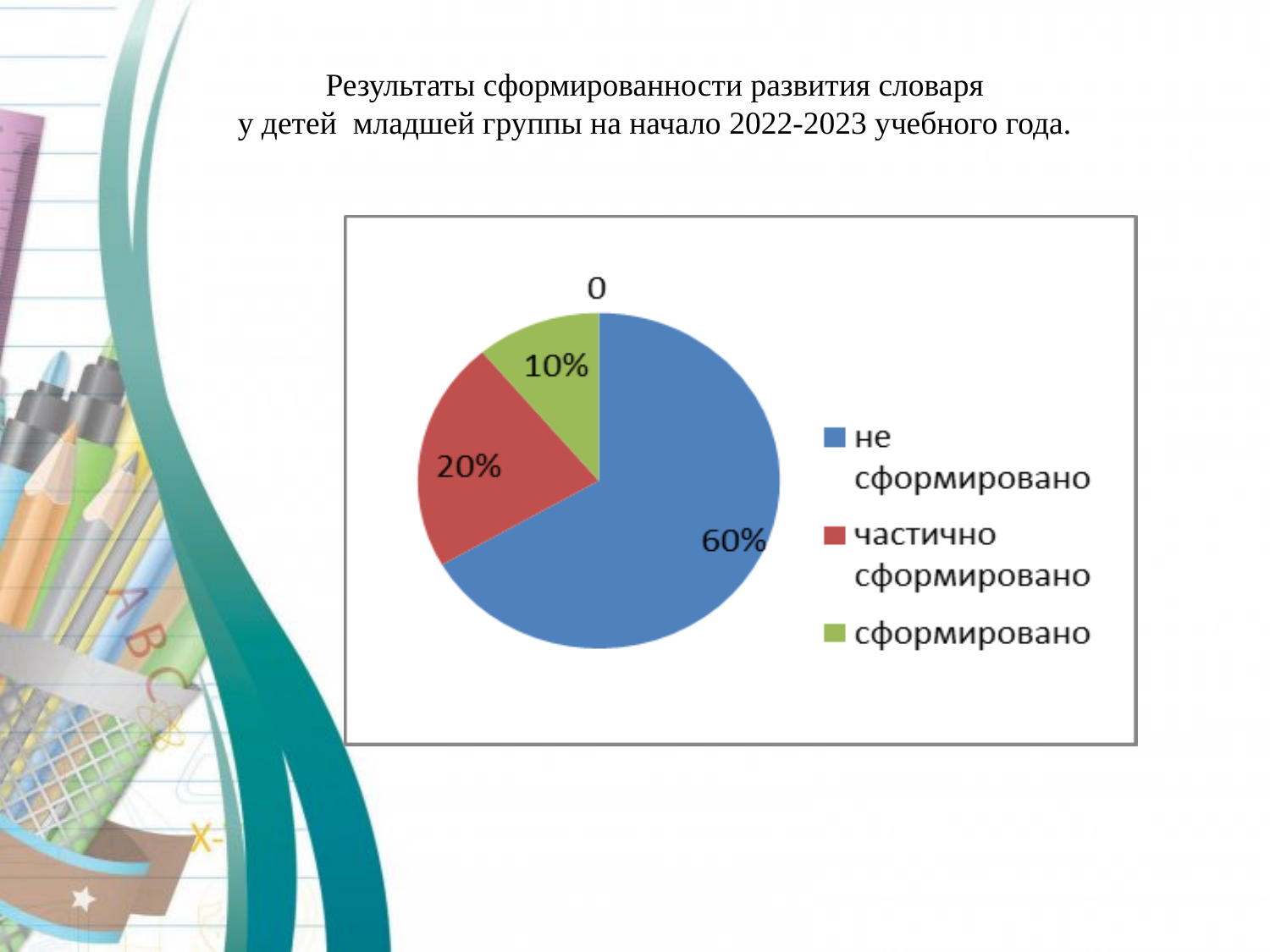
Which category has the largest slice of the pie? не сформировано What percentage is shown for the slice "сформировано"? 10% What kind of chart is shown on the slide? pie chart Which is larger: the slice for "частично сформировано" or the slice for "сформировано"? частично сформировано What is the difference between the percentages for "частично сформировано" and "сформировано"? 10% What percentage is shown for the slice "частично сформировано"? 20% What colour is the slice for "не сформировано"? blue Which legend category has the smallest slice of the pie? сформировано What colour is the slice for "сформировано"? green How many entries does the legend list? 3 What is the difference between the percentages for "не сформировано" and "частично сформировано"? 40% What percentage is shown for the slice "не сформировано"? 60%